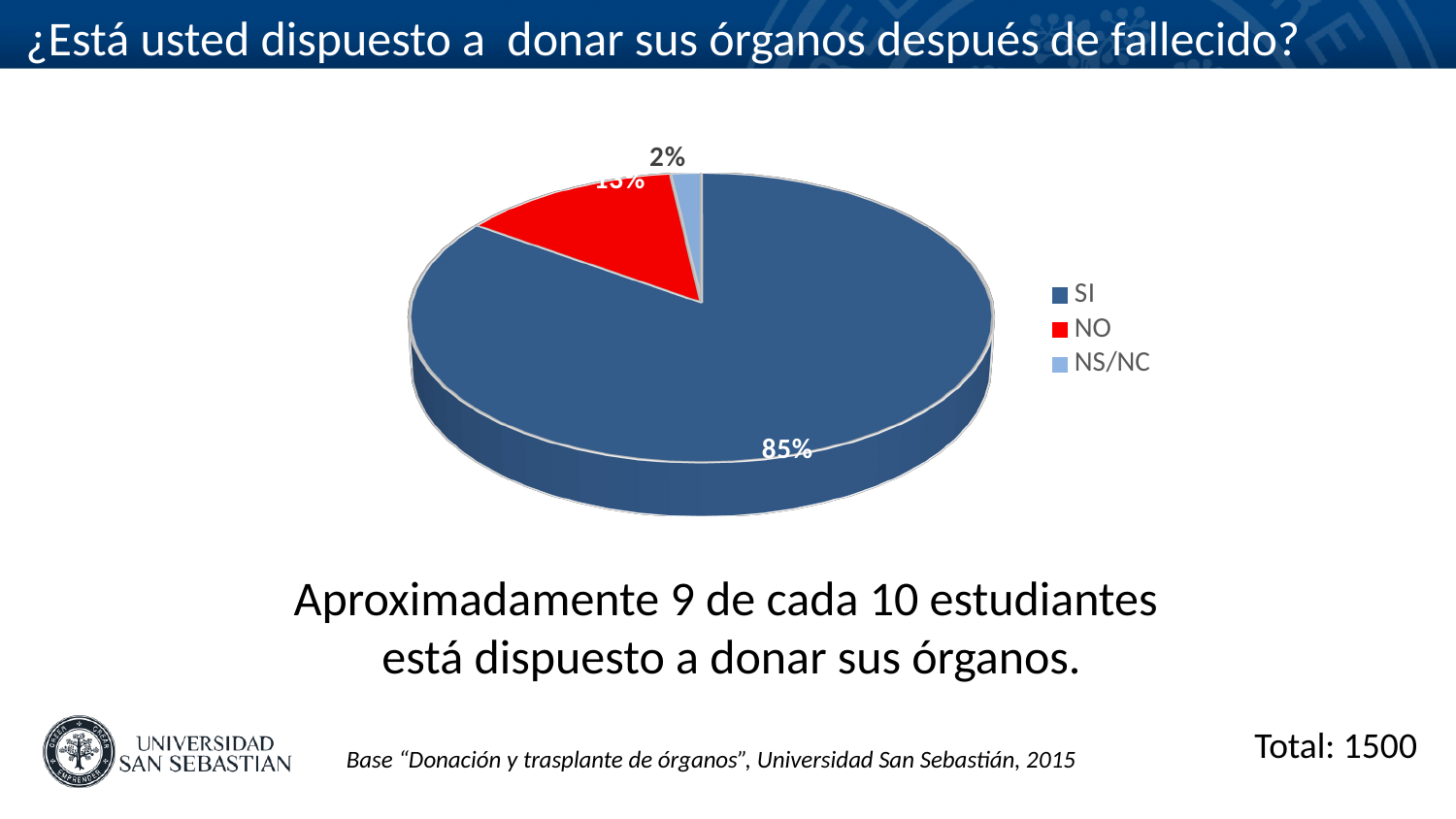
Which response category has the smallest share of the pie? NS/NC What kind of chart is shown on the slide? pie chart What is the difference in percentage points between the SI share and the NS/NC share? 83% How many categories does the legend list? 3 What colour is the NO slice in the pie chart? red What percentage of students answered SI (yes) to donating their organs after death? 85% What percentage of students answered NS/NC? 2% Which response category has the largest share of the pie? SI What is the total number of respondents stated on the slide? 1500 Which is larger, the share for NO or the share for NS/NC? NO